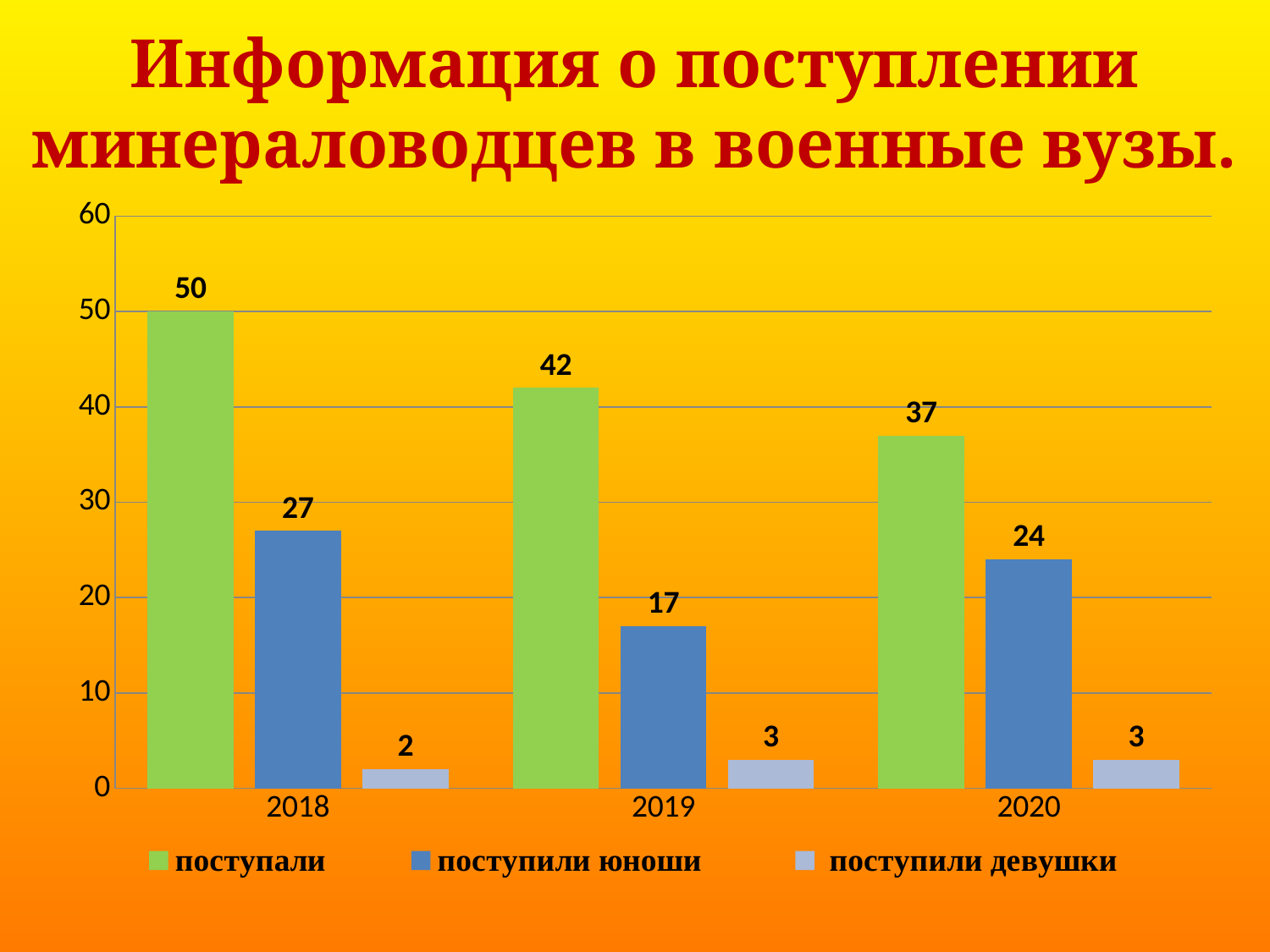
What is the difference between "поступали" and "поступили юноши" in 2020? 13 Does the value for "поступали" rise or fall from 2018 to 2020? fall How many years are shown on the x axis? 3 What is the value for "поступали" in 2018? 50 What is the value for "поступили юноши" in 2019? 17 Is the value for "поступали" in 2019 greater or less than 40? greater How many series does the legend list? 3 In which year is the value for "поступали" the highest? 2018 What kind of chart is shown on the slide? bar chart In which year is the value for "поступили юноши" the lowest? 2019 Which is larger: "поступили юноши" in 2018 or "поступили юноши" in 2020? 2018 What is the value for "поступили девушки" in 2020? 3